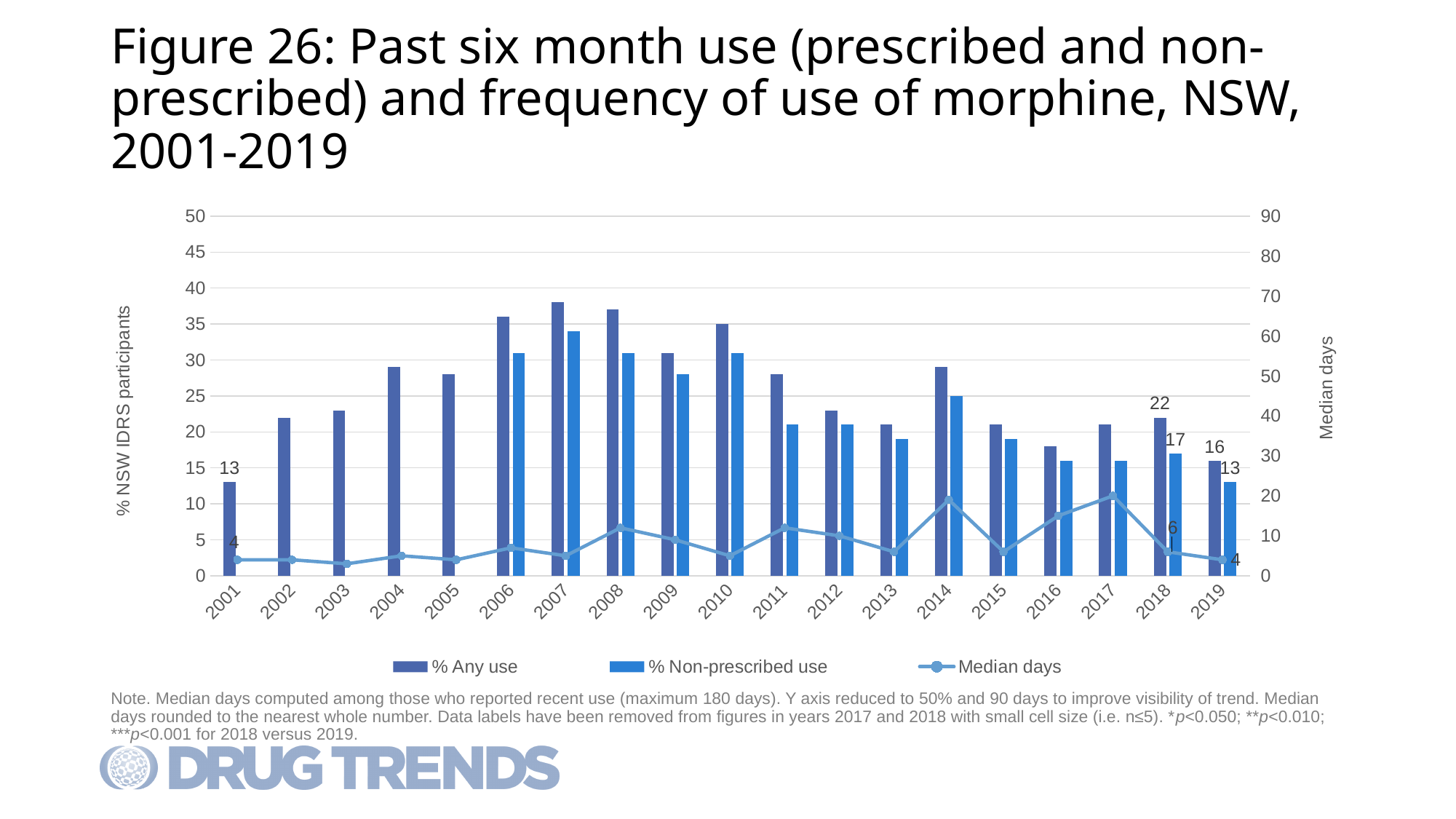
What is the difference between % Any use and % Non-prescribed use in 2018? 5 Is the value for % Any use in 2007 greater or less than 35? greater What is the value for % Any use in 2001? 13 What is the Median days value in 2019? 4 Which year has the larger Median days value, 2018 or 2019? 2018 What is the value for % Non-prescribed use in 2018? 17 How many years are shown on the x axis? 19 What is the value for % Any use in 2019? 16 How many series does the legend list? 3 Which year has the lowest value for % Any use? 2001 Does % Any use rise or fall from 2010 to 2013? fall Is the value for % Non-prescribed use in 2016 greater or less than 20? less